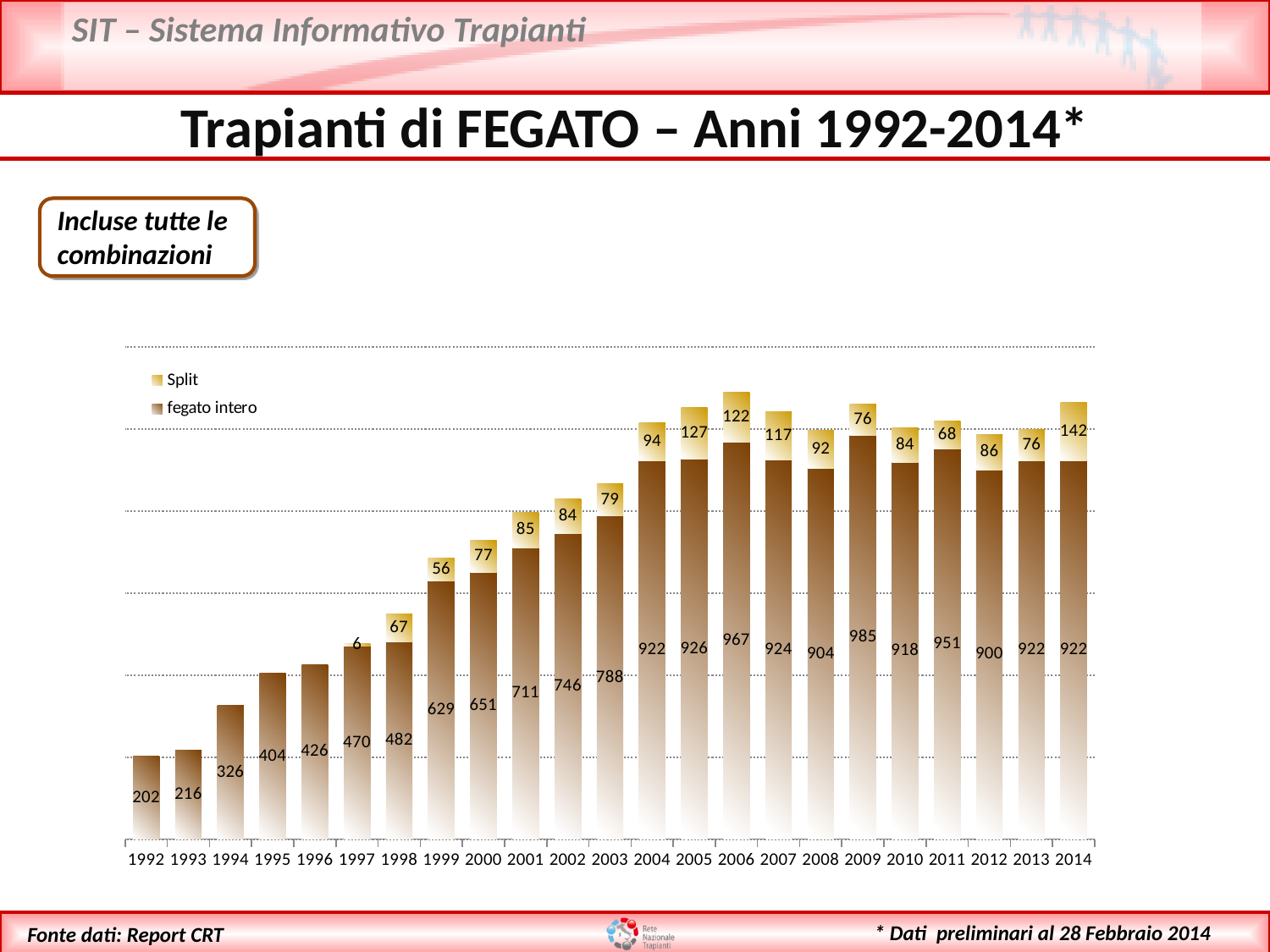
Which is larger, the Split value for 2005 or for 2006? 2005 What is the difference between the fegato intero values for 2006 and 2005? 41 Which year has the lowest fegato intero value? 1992 What is the Split value for 2014? 142 Which year has the highest fegato intero value? 2009 What is the value of fegato intero for 2009? 985 How many series does the legend list? 2 What kind of chart is shown on the slide? Stacked bar chart Which year has the highest Split value? 2014 What is the value of fegato intero for 1992? 202 How many years are shown on the x axis? 23 What is the total of the stacked bar for 2014? 1064